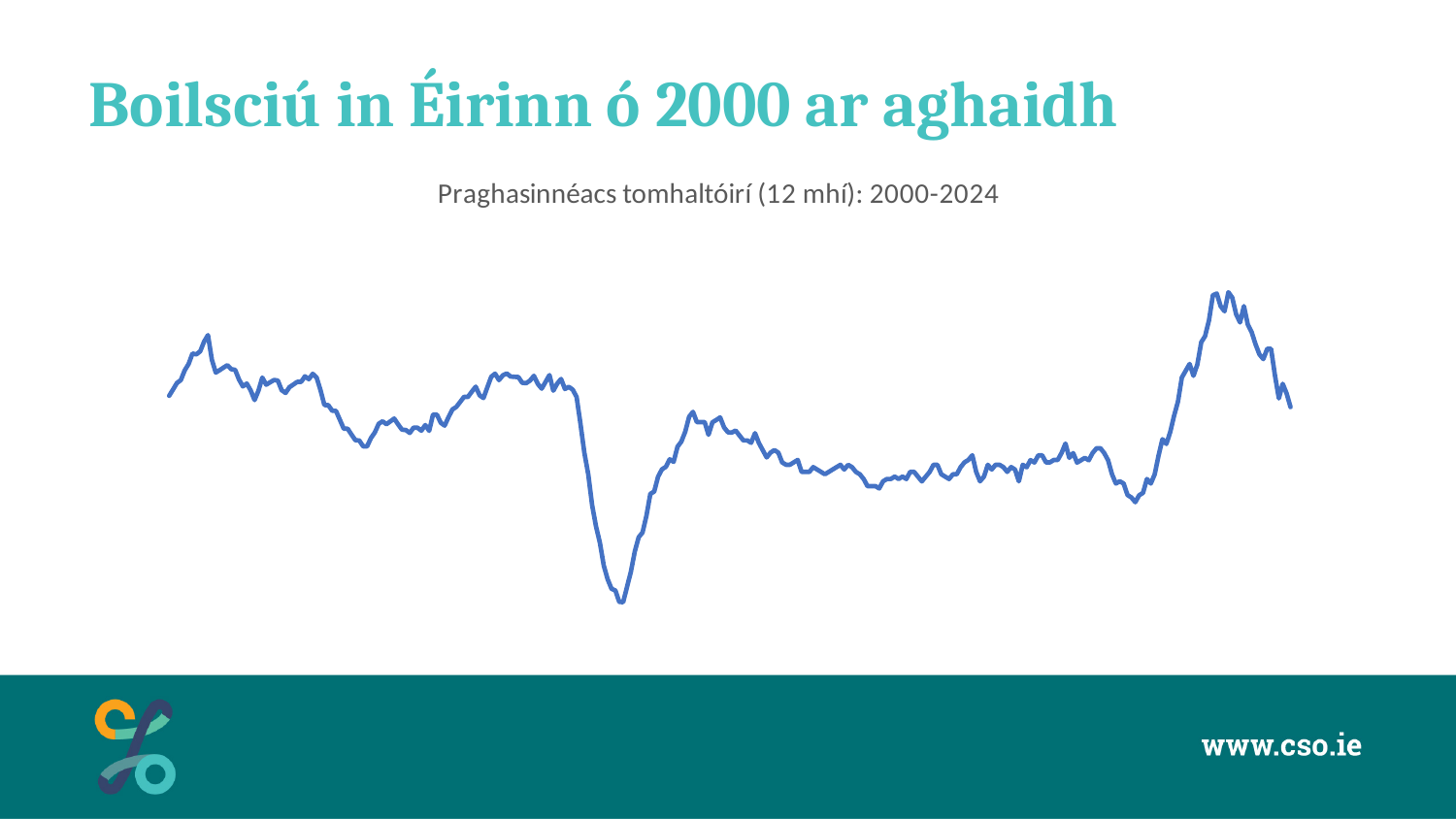
Is the highest point of the line in the left, middle or right part of the chart? Right What is the title of the chart? Praghasinnéacs tomhaltóirí (12 mhí): 2000-2024 Does the line rise or fall sharply just before reaching its lowest point? Fall Is the lowest point of the line in the left, middle or right part of the chart? Middle What kind of chart is shown on the slide? Line chart What colour is the line on the chart? Blue How many lines are plotted on the chart? 1